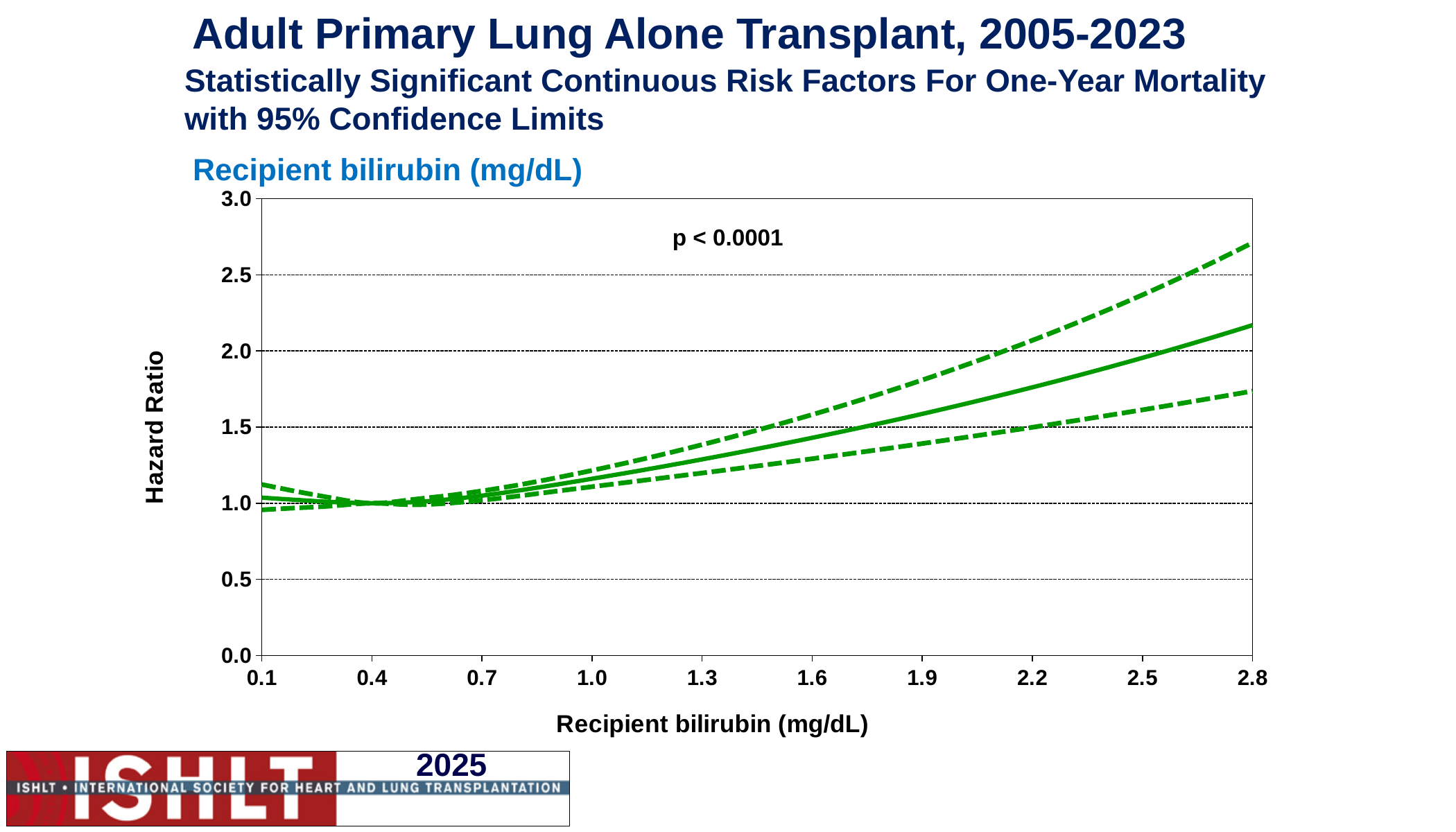
Does the hazard ratio (solid line) rise or fall as recipient bilirubin increases from 0.4 to 2.8 mg/dL? rise Is the hazard ratio of the solid line at a recipient bilirubin of 1.6 mg/dL greater or less than 1.5? less At which recipient bilirubin value on the x axis do the three lines converge at a hazard ratio of 1.0? 0.4 What p-value is printed on the chart? p < 0.0001 At which recipient bilirubin value on the x axis is the hazard ratio of the solid line highest? 2.8 What is the title of the chart? Recipient bilirubin (mg/dL) Is the lower dashed confidence limit at a recipient bilirubin of 2.8 mg/dL greater or less than 1.5? greater Is the upper dashed confidence limit at a recipient bilirubin of 2.8 mg/dL greater or less than 2.5? greater What kind of chart is shown on the slide? line chart What is the label of the y axis? Hazard Ratio How many lines are plotted on the chart? 3